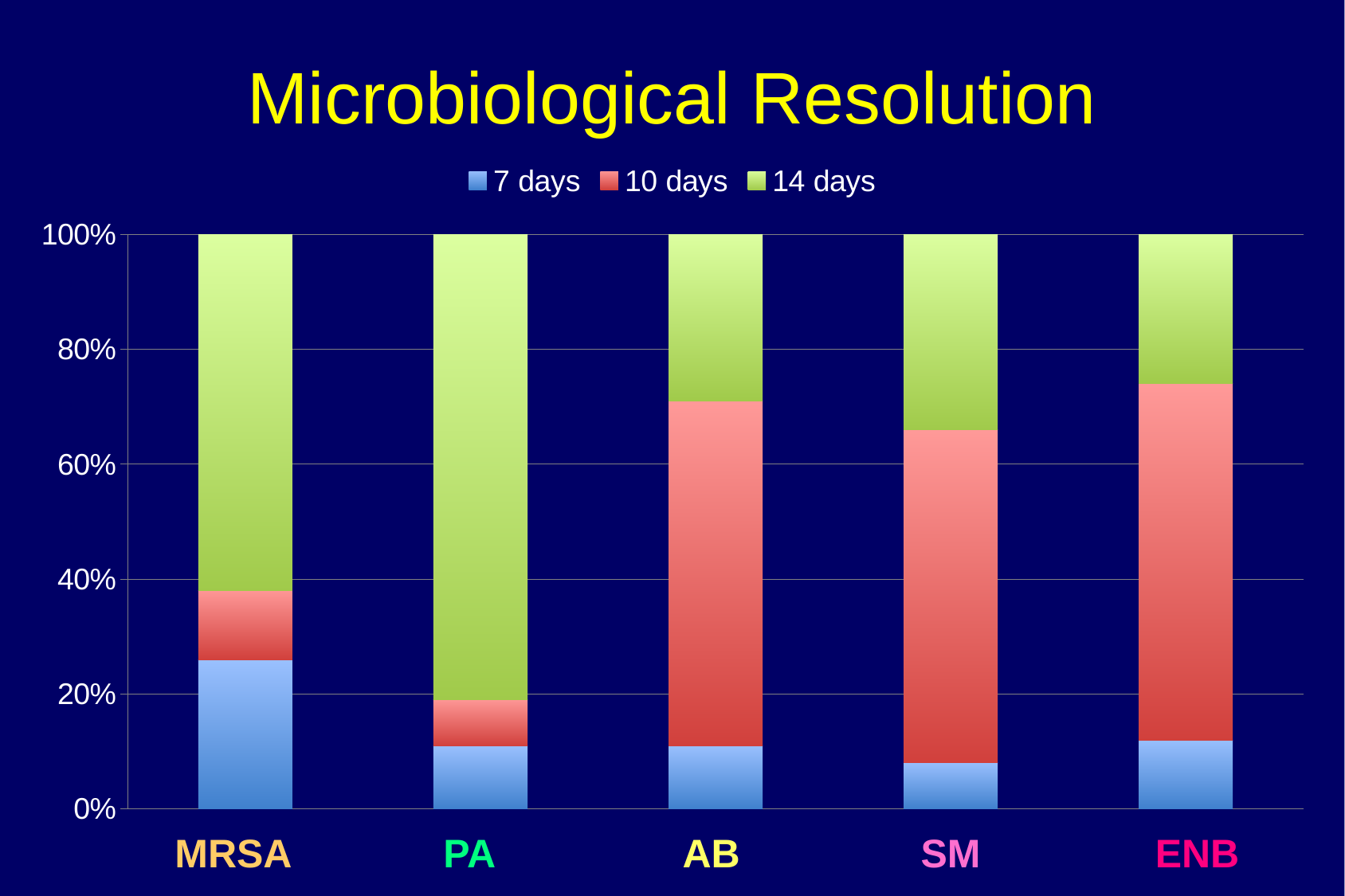
How many series does the legend list? 3 What kind of chart is shown on the slide? Stacked bar chart Is the 14 days share for PA greater or less than 60%? greater Is the 7 days share for SM greater or less than 20%? less What is the title of the chart? Microbiological Resolution Which category has the largest 7 days share? MRSA Which category has the largest 14 days share? PA Which series is shown in green in the legend? 14 days Is the 7 days share for MRSA greater or less than 20%? greater Which is larger, the 14 days share for PA or the 14 days share for SM? PA How many categories are shown along the x axis? 5 Which is larger, the 10 days share for AB or the 10 days share for MRSA? AB